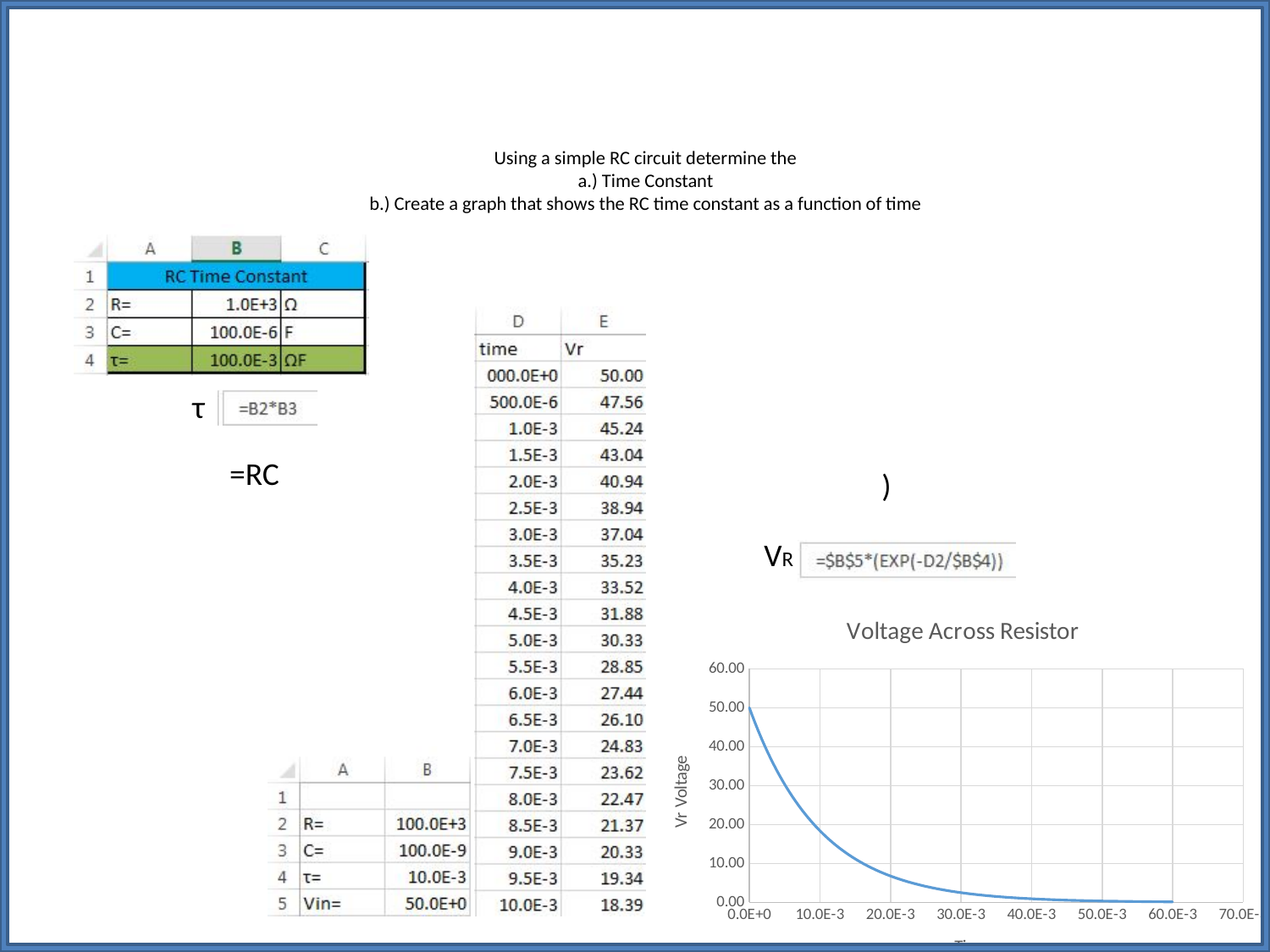
Is the Vr Voltage at time 0.0E+0 greater or less than 40.00? greater Is the Vr Voltage at time 5.0E-3 greater or less than 20.00? greater Is the Vr Voltage at time 20.0E-3 greater or less than 10.00? less What is the title of the chart? Voltage Across Resistor What is the label on the vertical axis of the chart? Vr Voltage What is the highest value shown on the vertical axis of the chart? 60.00 Which is larger in the chart: the Vr Voltage at 10.0E-3 or at 30.0E-3? 10.0E-3 What kind of chart is shown on the slide? line chart Do the values in the chart rise or fall as time increases along the x axis? fall What is the Vr Voltage at time 0.0E+0 in the chart? 50.00 At which time on the x axis is the Vr Voltage highest? 0.0E+0